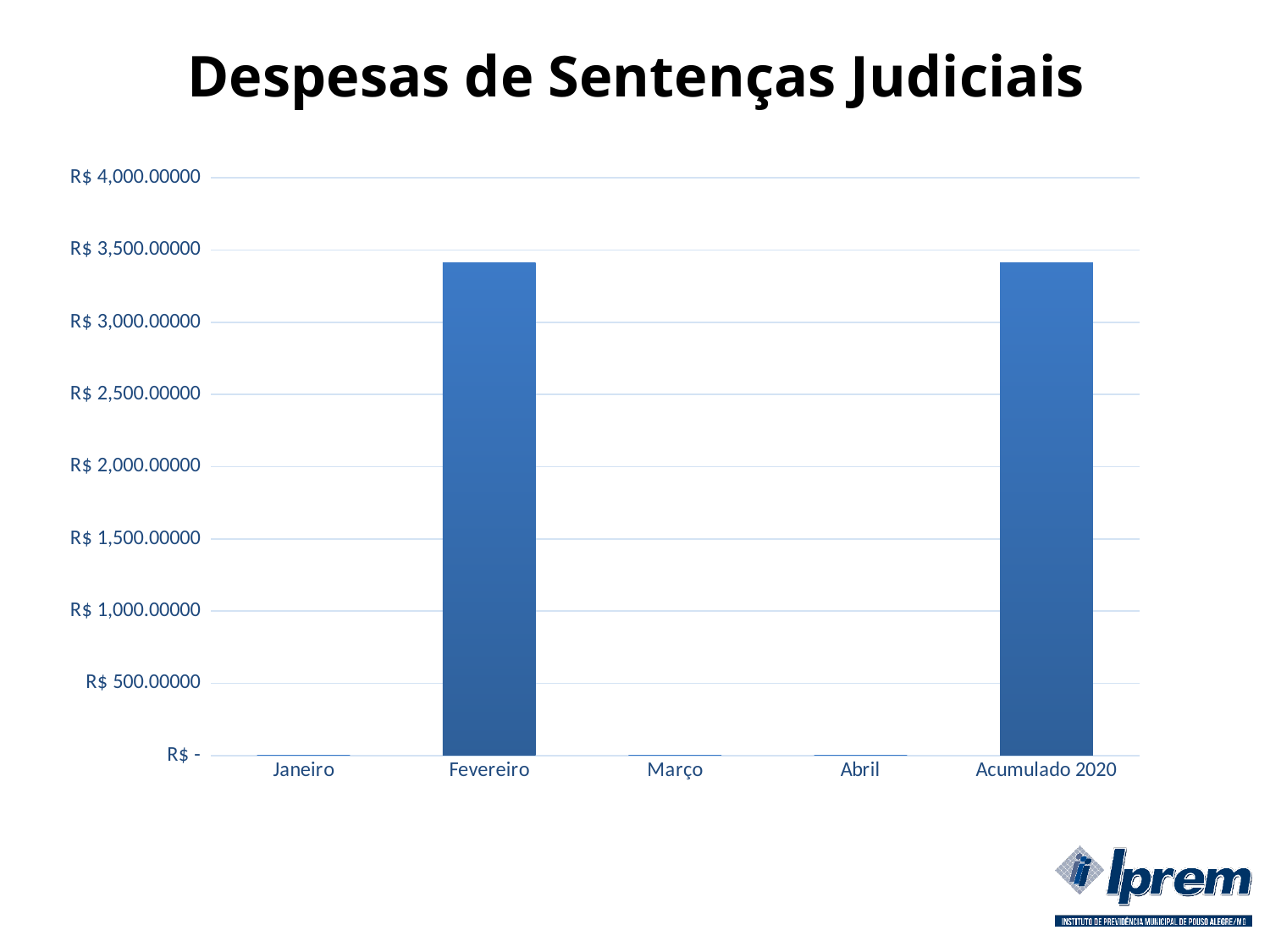
Which is larger, the value for Fevereiro or the value for Março? Fevereiro How many categories have a visible bar above the zero line? 2 Is the value for Fevereiro greater or less than R$ 3,000.00000? greater What is the highest value labelled on the y axis? R$ 4,000.00000 Is the value for Fevereiro greater or less than R$ 3,500.00000? less What kind of chart is shown on the slide? bar chart Is the value for Janeiro greater or less than R$ 500.00000? less What is the title of the chart? Despesas de Sentenças Judiciais How many categories are shown on the x axis of the chart? 5 Which is larger, the value for Abril or the value for Acumulado 2020? Acumulado 2020